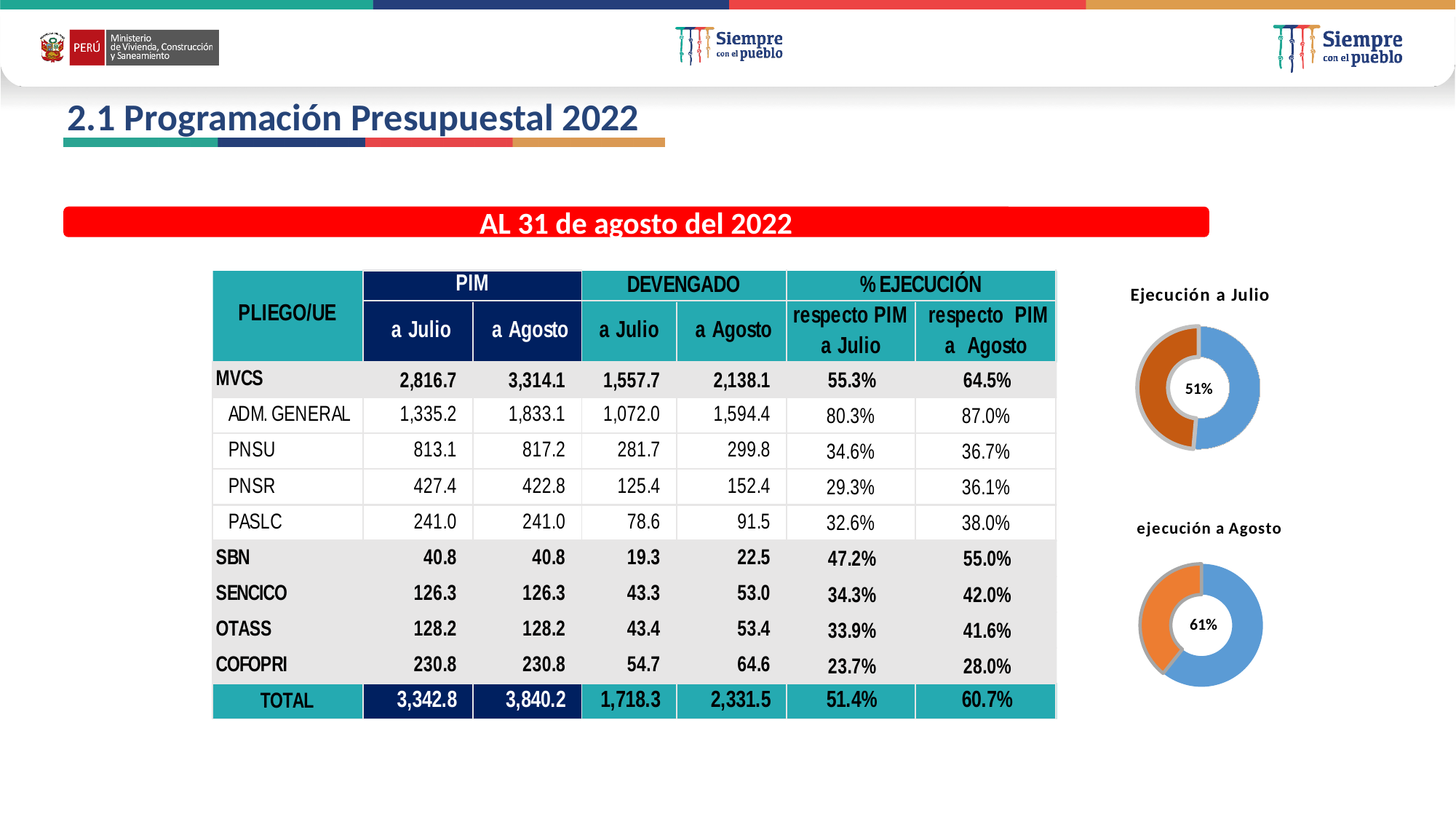
What is the title of the lower donut chart on the right side of the slide? ejecución a Agosto What kind of chart is used for "Ejecución a Julio"? Donut (pie) chart What is the title of the upper donut chart on the right side of the slide? Ejecución a Julio What percentage is shown in the centre of the "ejecución a Agosto" chart? 61% How many slices does the "Ejecución a Julio" donut chart have? 2 How many donut charts are shown on the slide? 2 By how many percentage points does the value in the "ejecución a Agosto" chart exceed the value in the "Ejecución a Julio" chart? 10 percentage points Does the execution percentage rise or fall from the "Ejecución a Julio" chart to the "ejecución a Agosto" chart? Rises Which chart shows the higher execution percentage, "Ejecución a Julio" or "ejecución a Agosto"? ejecución a Agosto What percentage is shown in the centre of the "Ejecución a Julio" chart? 51%